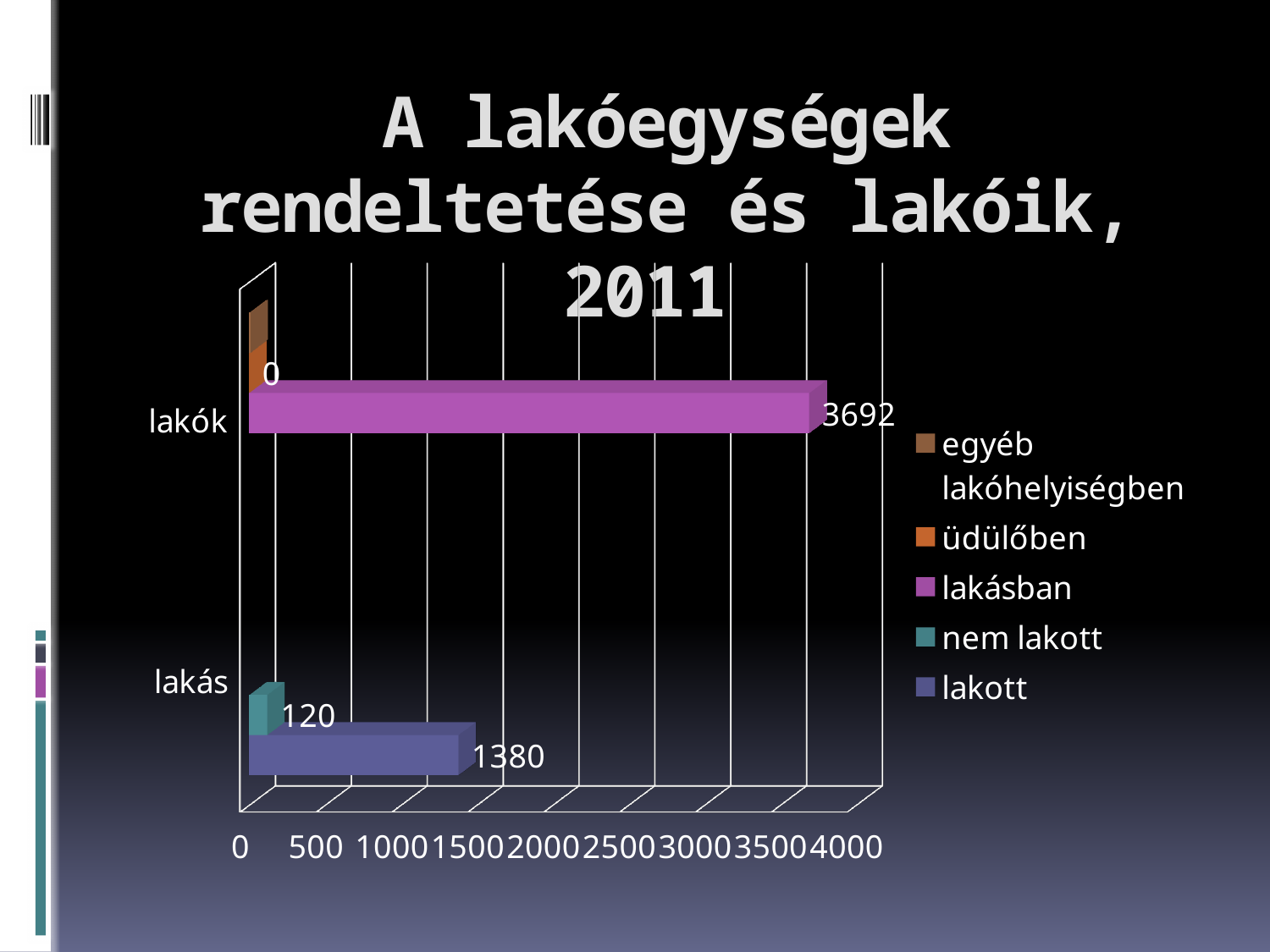
How many series does the legend list? 5 Is the lakott value for lakás greater or less than 1000? greater What is the value of the nem lakott series for the lakás category? 120 What is the value of the lakott series for the lakás category? 1380 Is the lakásban value for lakók greater or less than 3500? greater What is the value of the lakásban series for the lakók category? 3692 For the lakás category, which is larger: lakott or nem lakott? lakott What kind of chart is shown on the slide? bar chart How many categories are shown on the vertical axis of the chart? 2 What is the title of the chart? A lakóegységek rendeltetése és lakóik, 2011 Which series has the highest value shown on the chart? lakásban What is the difference between the lakott and nem lakott values for the lakás category? 1260